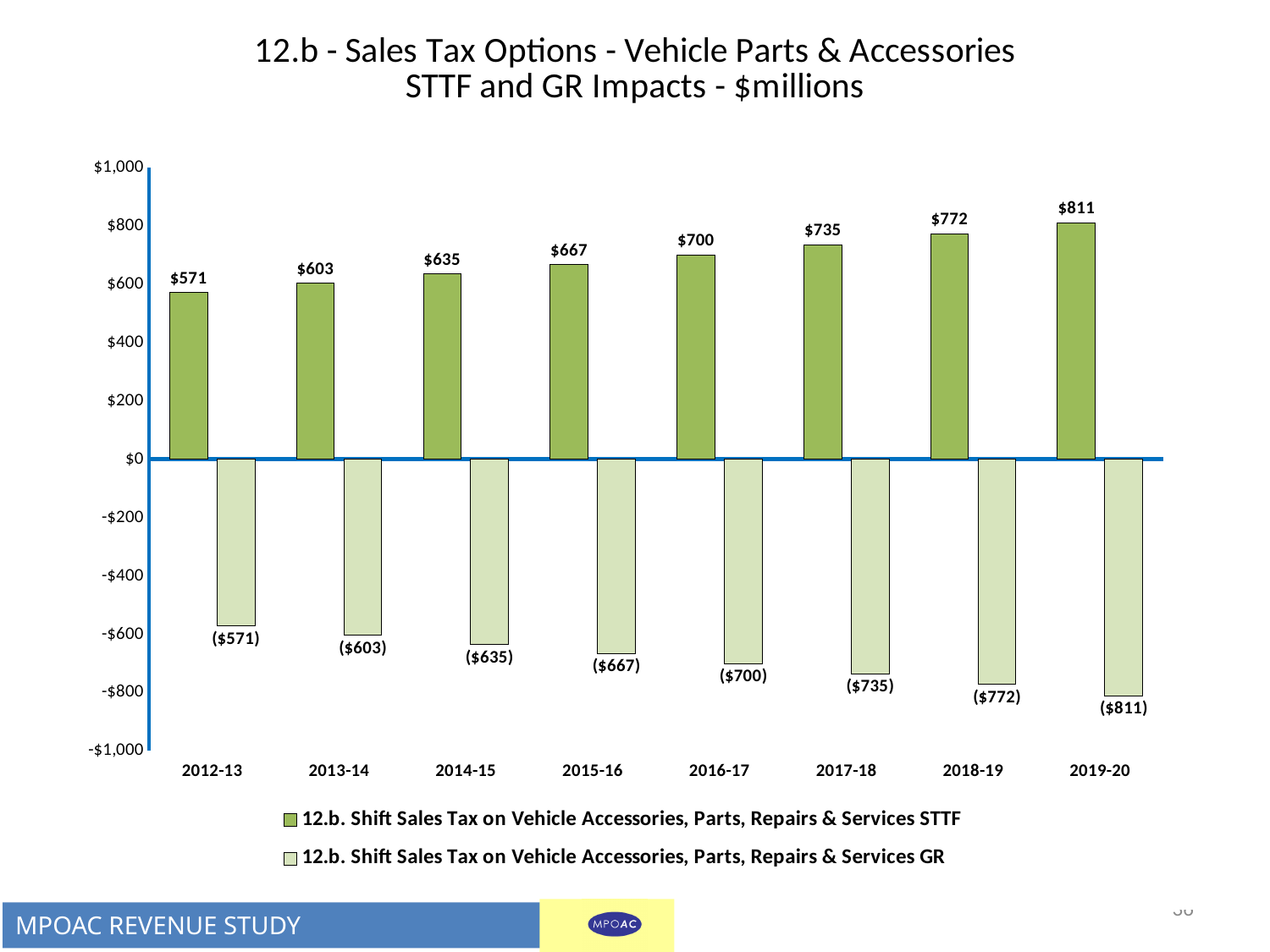
What is the STTF value for 2012-13? $571 What kind of chart is shown on the slide? Bar chart How many series does the legend list? 2 What is the GR value for 2019-20? ($811) What is the difference between the STTF values for 2019-20 and 2012-13? $240 Do the STTF values rise or fall from 2012-13 to 2019-20? Rise Which year has the highest STTF value? 2019-20 What is the title of the chart? 12.b - Sales Tax Options - Vehicle Parts & Accessories STTF and GR Impacts - $millions Which is larger, the STTF value for 2015-16 or for 2017-18? 2017-18 What is the STTF value for 2016-17? $700 How many fiscal years are shown on the x axis? 8 Which year has the lowest STTF value? 2012-13